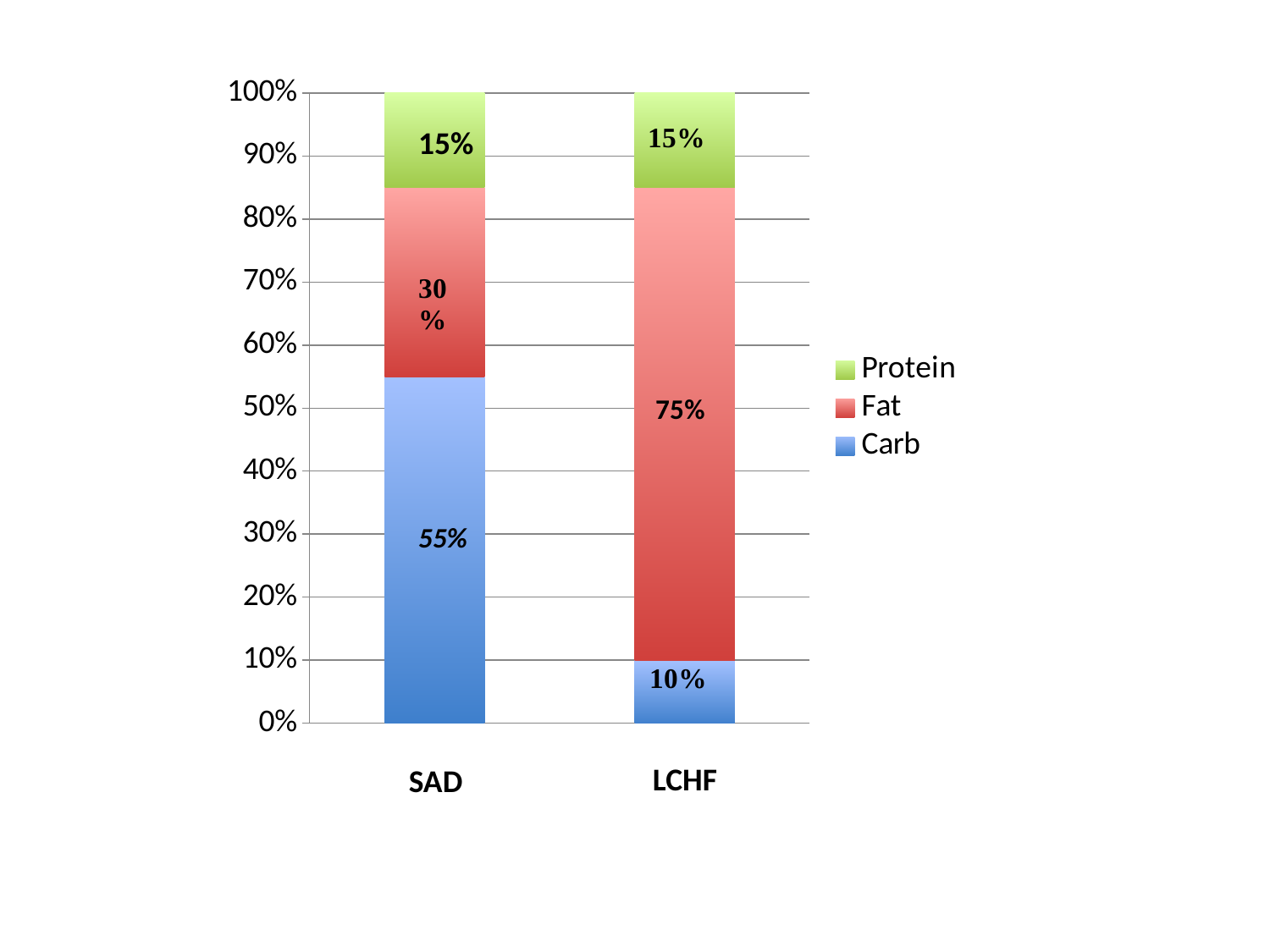
What is the Fat value for SAD? 30% What is the Carb value for SAD? 55% What is the Protein value for LCHF? 15% What is the Fat value for LCHF? 75% What is the difference between the Carb values for SAD and LCHF? 45% What is the Carb value for LCHF? 10% Which category has the higher Fat value, SAD or LCHF? LCHF What is the difference between the Fat values for LCHF and SAD? 45% How many categories are shown on the x axis? 2 How many series does the legend list? 3 Which category has the lower Carb value? LCHF What kind of chart is this? Stacked bar chart